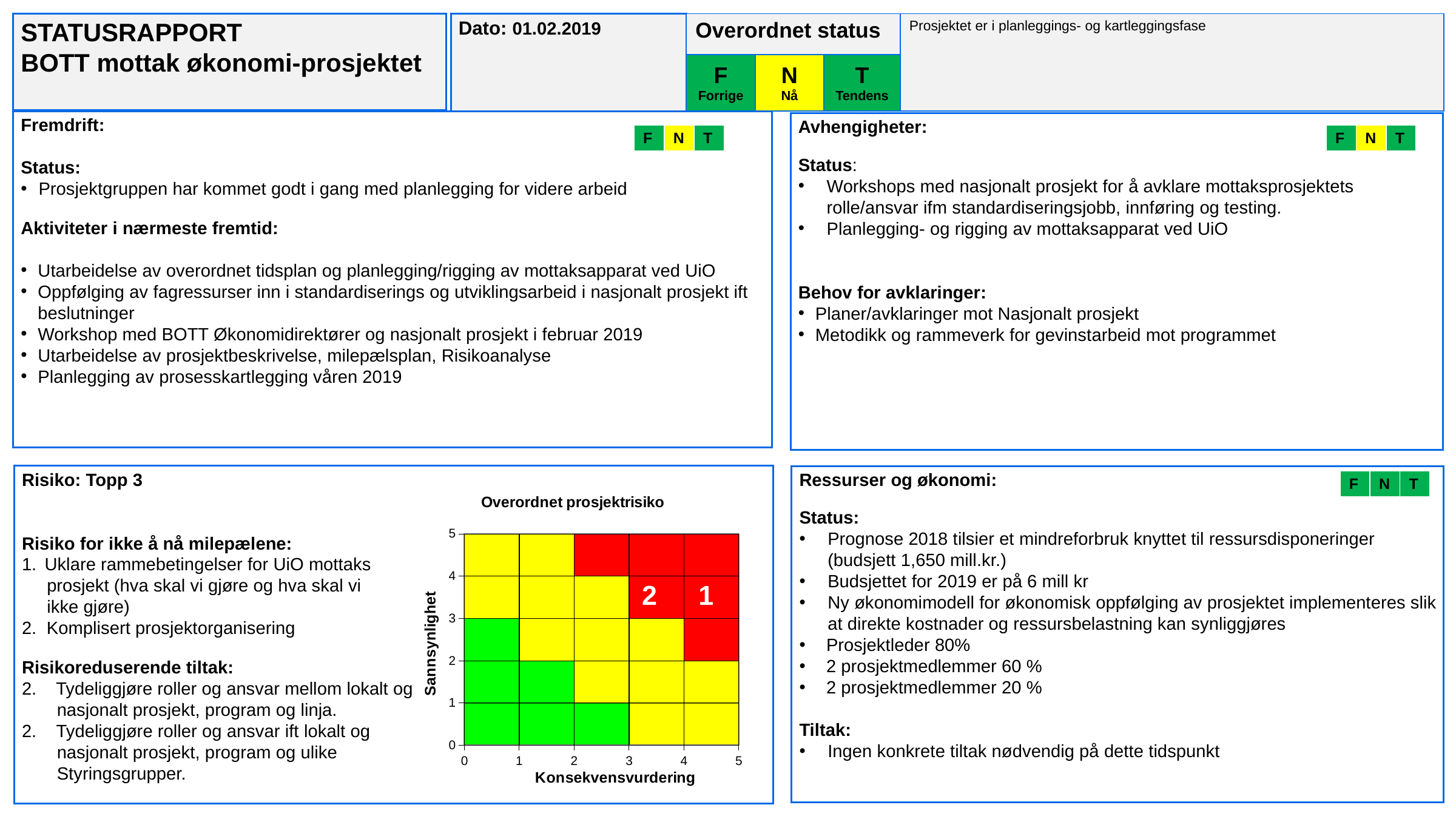
On the Overordnet prosjektrisiko chart, which risk has the higher Konsekvensvurdering, 1 or 2? 1 What is the label of the x axis of the Overordnet prosjektrisiko chart? Konsekvensvurdering What is the label of the y axis of the Overordnet prosjektrisiko chart? Sannsynlighet What kind of chart is Overordnet prosjektrisiko? Risk matrix (heat map grid) What is the title of the chart in the Risiko: Topp 3 section? Overordnet prosjektrisiko On the Overordnet prosjektrisiko chart, is the Konsekvensvurdering for risk 1 greater or less than 3? greater On the Overordnet prosjektrisiko chart, what colour are the cells in which risks 1 and 2 are placed? Red On the Overordnet prosjektrisiko chart, is the Sannsynlighet for risk 2 greater or less than 2? greater How many risks are plotted on the Overordnet prosjektrisiko chart? 2 What is the maximum value shown on the x axis of the Overordnet prosjektrisiko chart? 5 What is the minimum value shown on the y axis of the Overordnet prosjektrisiko chart? 0 On the Overordnet prosjektrisiko chart, is the Konsekvensvurdering for risk 2 greater or less than 2? greater